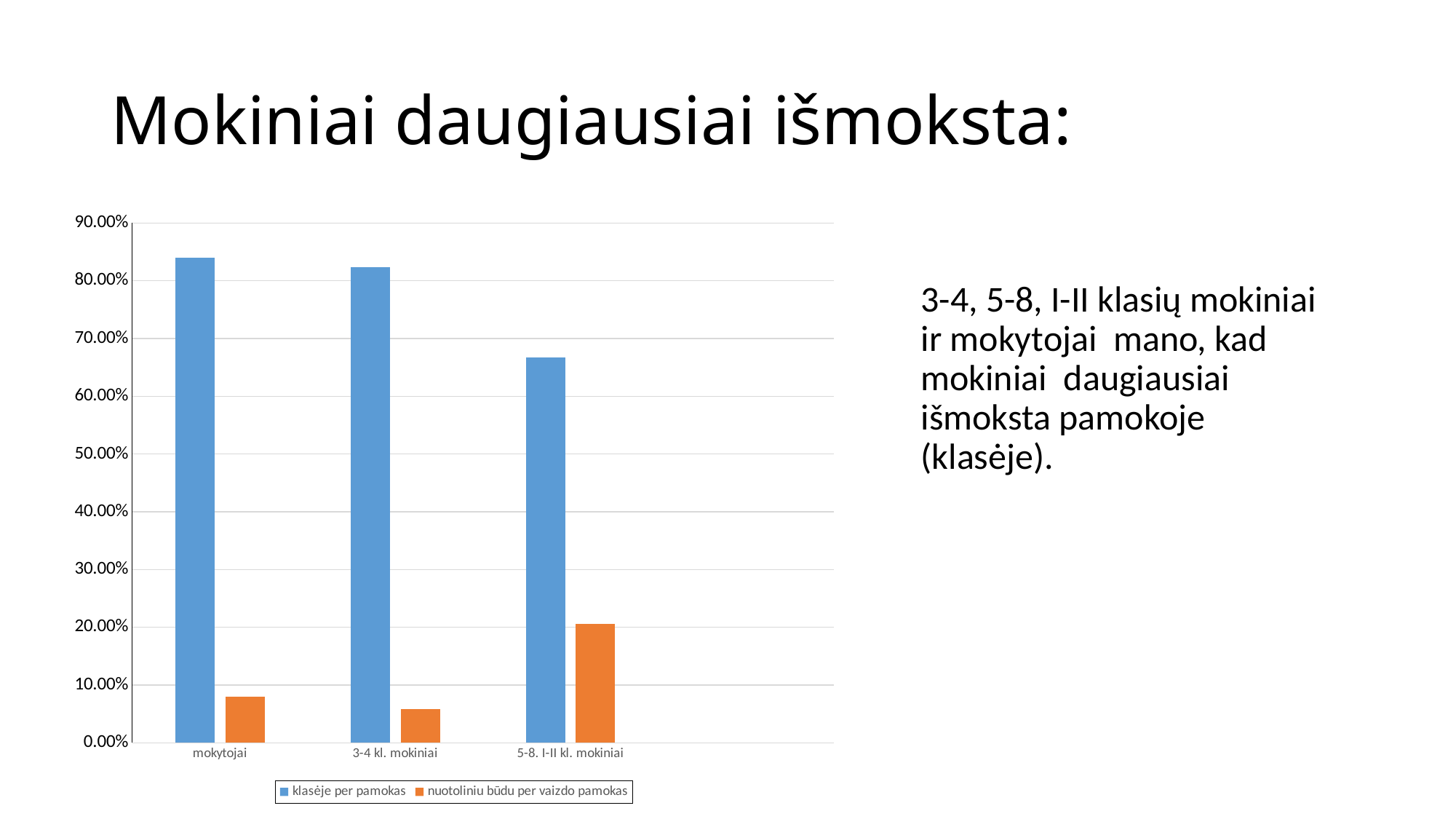
Is the value for 'klasėje per pamokas' for 5-8. I-II kl. mokiniai greater or less than 70.00%? less How many categories are shown on the x axis of the chart? 3 Do the values for the series 'klasėje per pamokas' rise or fall from left to right across the categories? fall Is the value for 'nuotoliniu būdu per vaizdo pamokas' for mokytojai greater or less than 10.00%? less For 3-4 kl. mokiniai, which series has the larger value: 'klasėje per pamokas' or 'nuotoliniu būdu per vaizdo pamokas'? klasėje per pamokas How many series does the chart's legend list? 2 What colour are the bars for the series 'nuotoliniu būdu per vaizdo pamokas'? orange What kind of chart is shown on the slide? bar chart Which category has the highest value for the series 'nuotoliniu būdu per vaizdo pamokas'? 5-8. I-II kl. mokiniai Which category has the lowest value for the series 'klasėje per pamokas'? 5-8. I-II kl. mokiniai Is the value for 'klasėje per pamokas' for mokytojai greater or less than 80.00%? greater